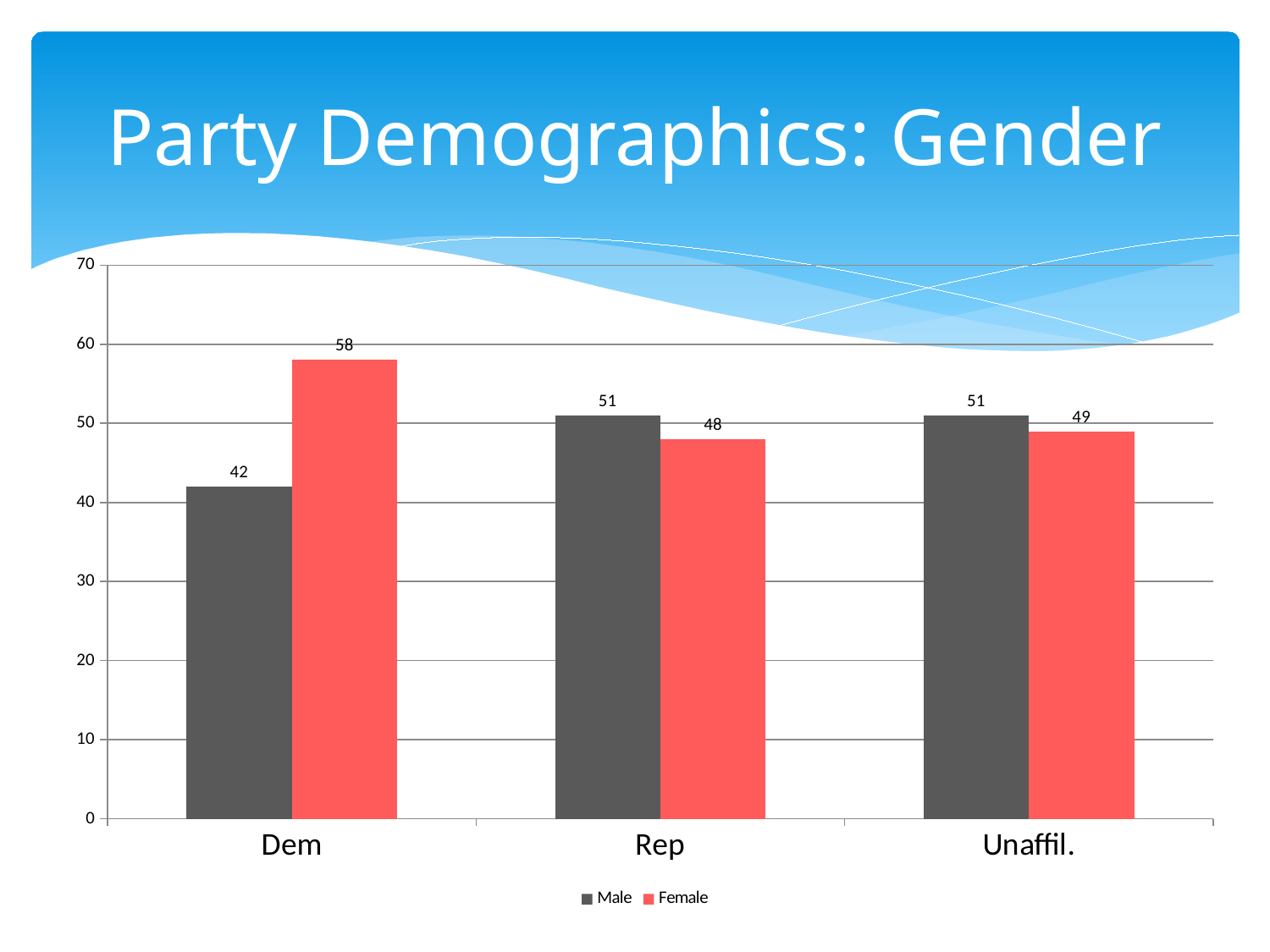
What is the Male value for Dem? 42 What is the Female value for Rep? 48 What is the Male value for Unaffil.? 51 How many categories are shown on the x axis? 3 What is the Female value for Dem? 58 How many series does the legend list? 2 Which category has the highest Female value? Dem For Rep, which is larger, the Male value or the Female value? Male What colour are the Female bars? Red What kind of chart is shown on the slide? Bar chart Which category has the lowest Male value? Dem What is the difference between the Female and Male values for Dem? 16